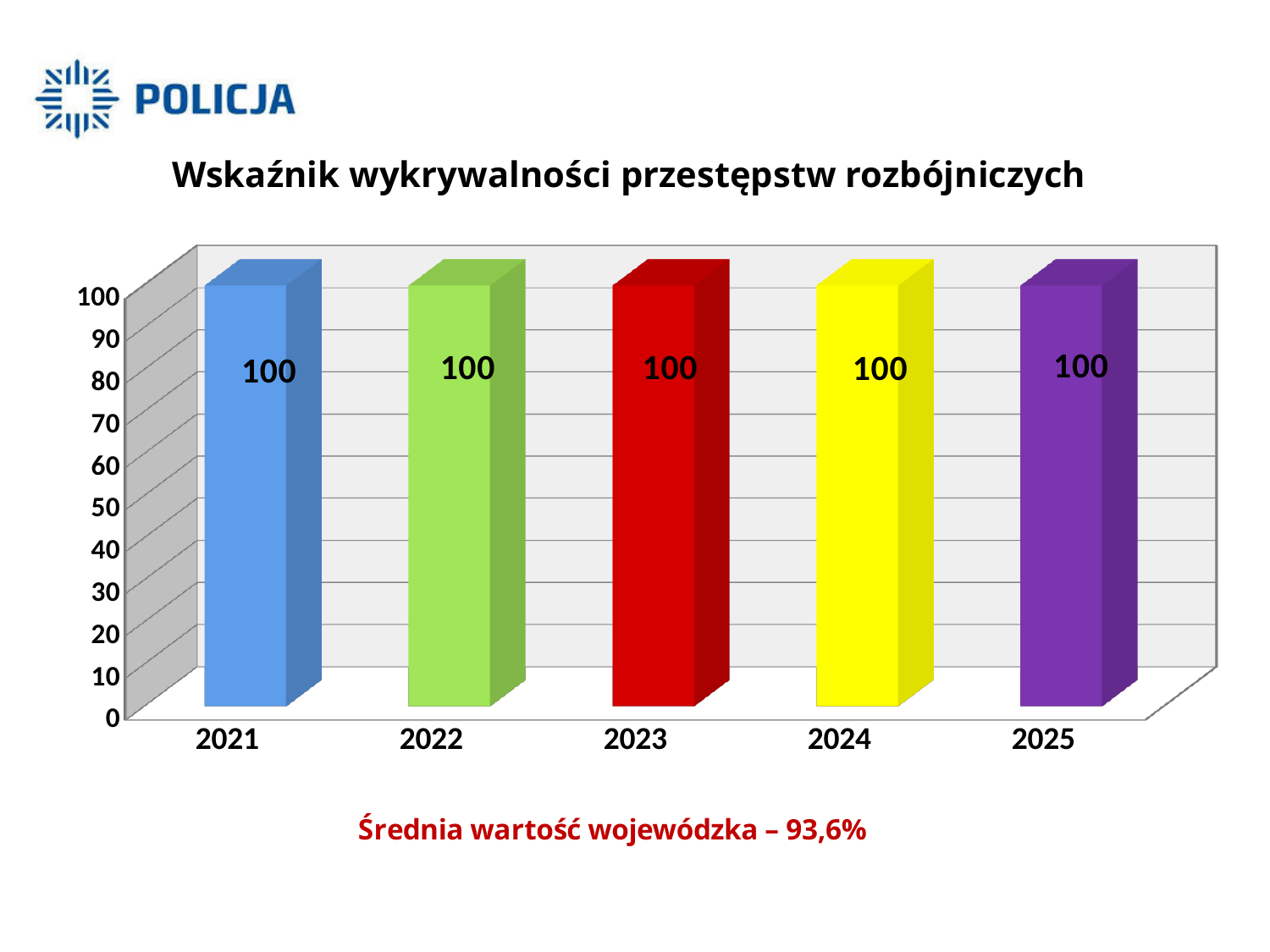
What is the value for 2025? 100 How many years are shown on the x axis? 5 What is the difference between the values for 2022 and 2024? 0 Do the values rise, fall or stay the same from 2021 to 2025? stay the same What is the highest value shown on the vertical axis? 100 What kind of chart is shown on the slide? bar chart What is the value for 2023? 100 What colour is the bar for 2023? red What is the title of the chart? Wskaźnik wykrywalności przestępstw rozbójniczych Is the value for 2024 greater or less than 50? greater What is the value for 2021? 100 What is the total of the values for 2021 and 2022? 200